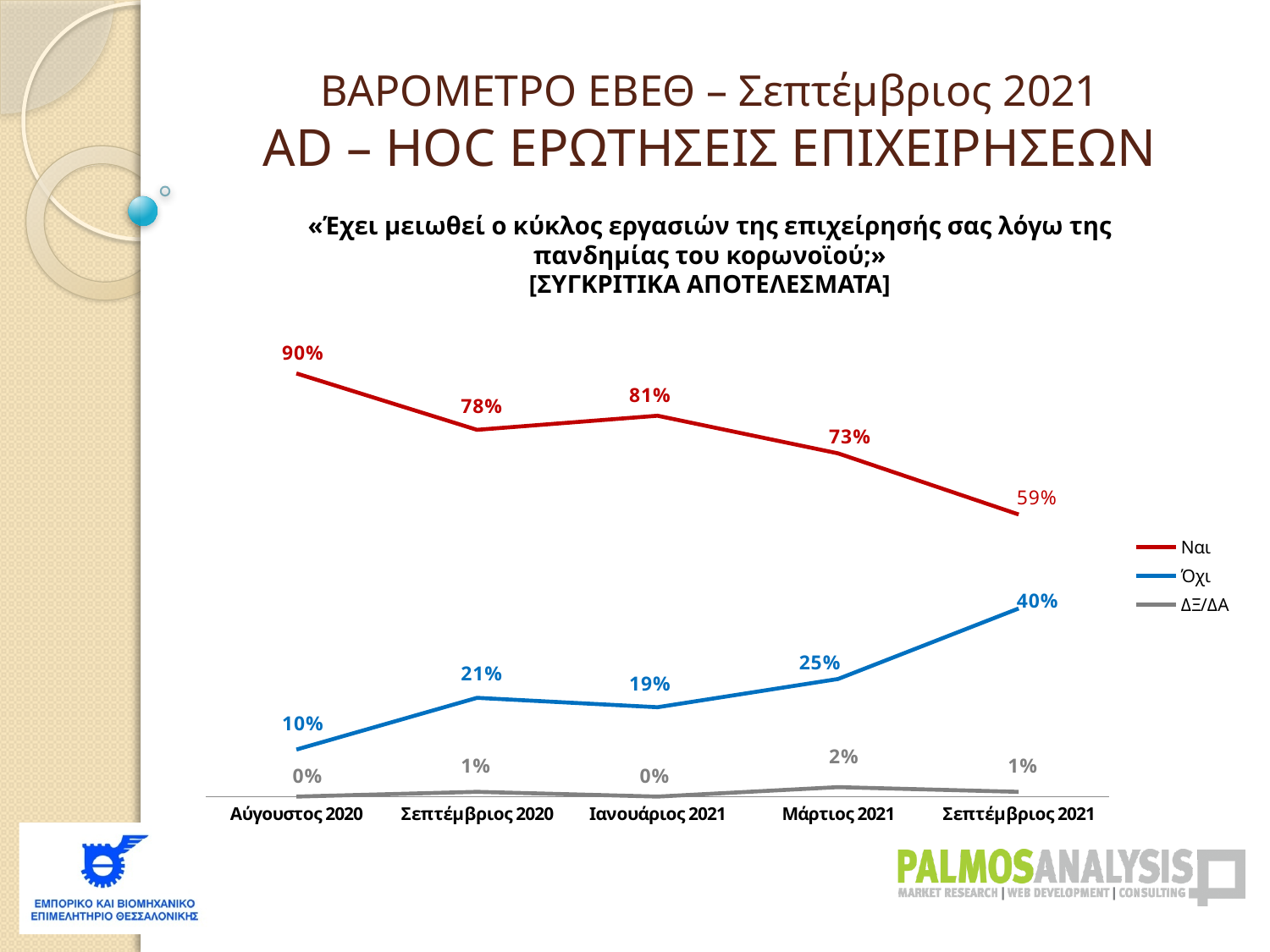
How many series does the legend list? 3 In which period is the Όχι series at its highest? Σεπτέμβριος 2021 What kind of chart is shown on the slide? Line chart What is the value of the ΔΞ/ΔΑ series for Μάρτιος 2021? 2% Does the Όχι series generally rise or fall from Αύγουστος 2020 to Σεπτέμβριος 2021? Rise How many time periods are shown on the x axis? 5 What is the difference between the Ναι value for Αύγουστος 2020 and the Ναι value for Σεπτέμβριος 2021? 31% What is the value of the Όχι series for Σεπτέμβριος 2021? 40% What is the value of the Ναι series for Αύγουστος 2020? 90% In which period is the Ναι series at its lowest? Σεπτέμβριος 2021 Which is larger for Σεπτέμβριος 2020: the Ναι value or the Όχι value? Ναι What is the value of the Ναι series for Ιανουάριος 2021? 81%